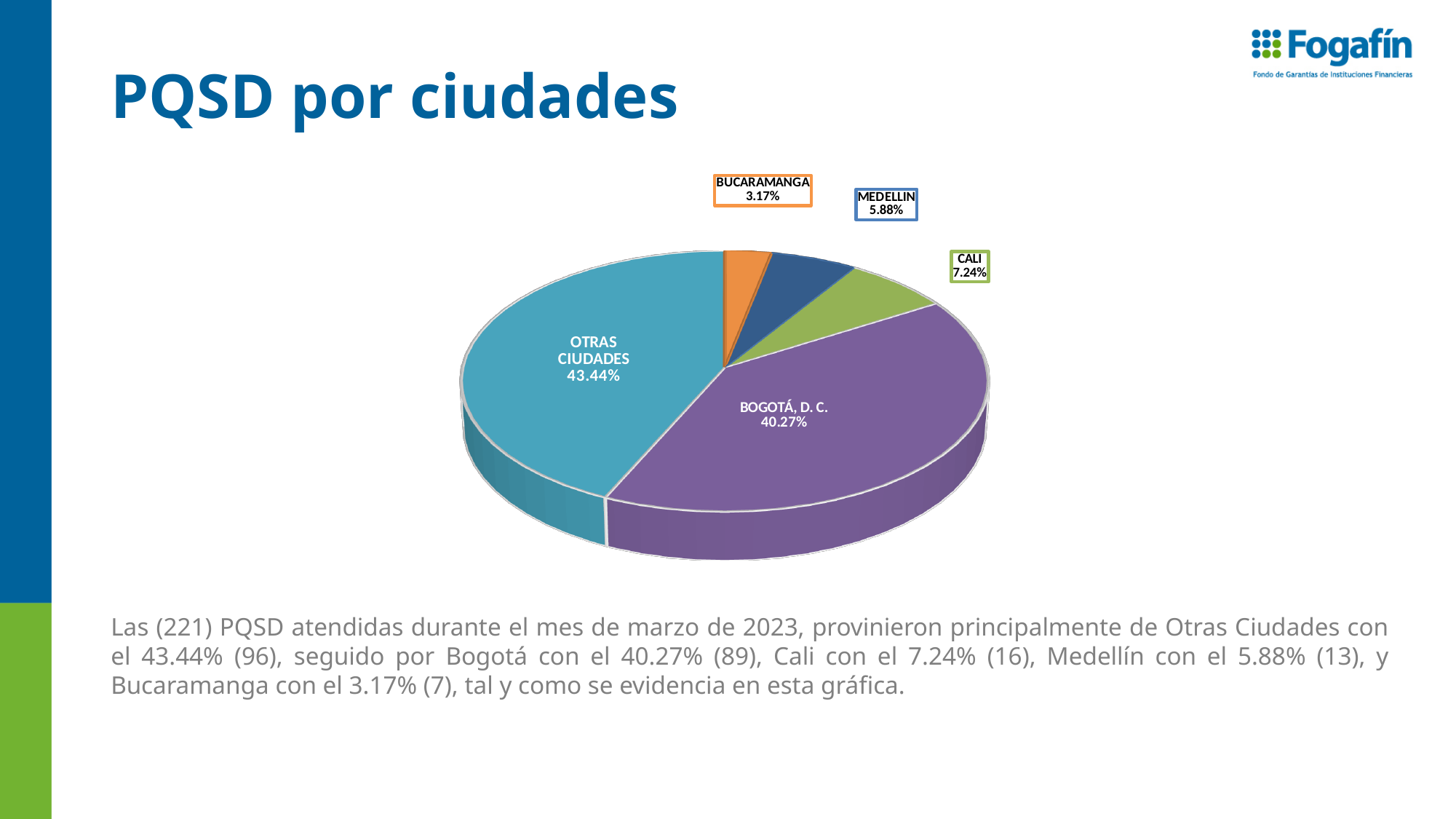
Which slice of the pie is the smallest? BUCARAMANGA What share of the pie does OTRAS CIUDADES represent? 43.44% What is the value shown for MEDELLIN? 5.88% What is the value shown for BUCARAMANGA? 3.17% What kind of chart is shown on the slide? Pie chart Which is larger, the share for CALI or the share for MEDELLIN? CALI What share of the pie does BOGOTÁ, D. C. represent? 40.27% What colour is the BOGOTÁ, D. C. slice? Purple How many slices does the pie chart have? 5 What is the value shown for CALI? 7.24% What is the difference in percentage points between OTRAS CIUDADES and BOGOTÁ, D. C.? 3.17 Which slice of the pie is the largest? OTRAS CIUDADES